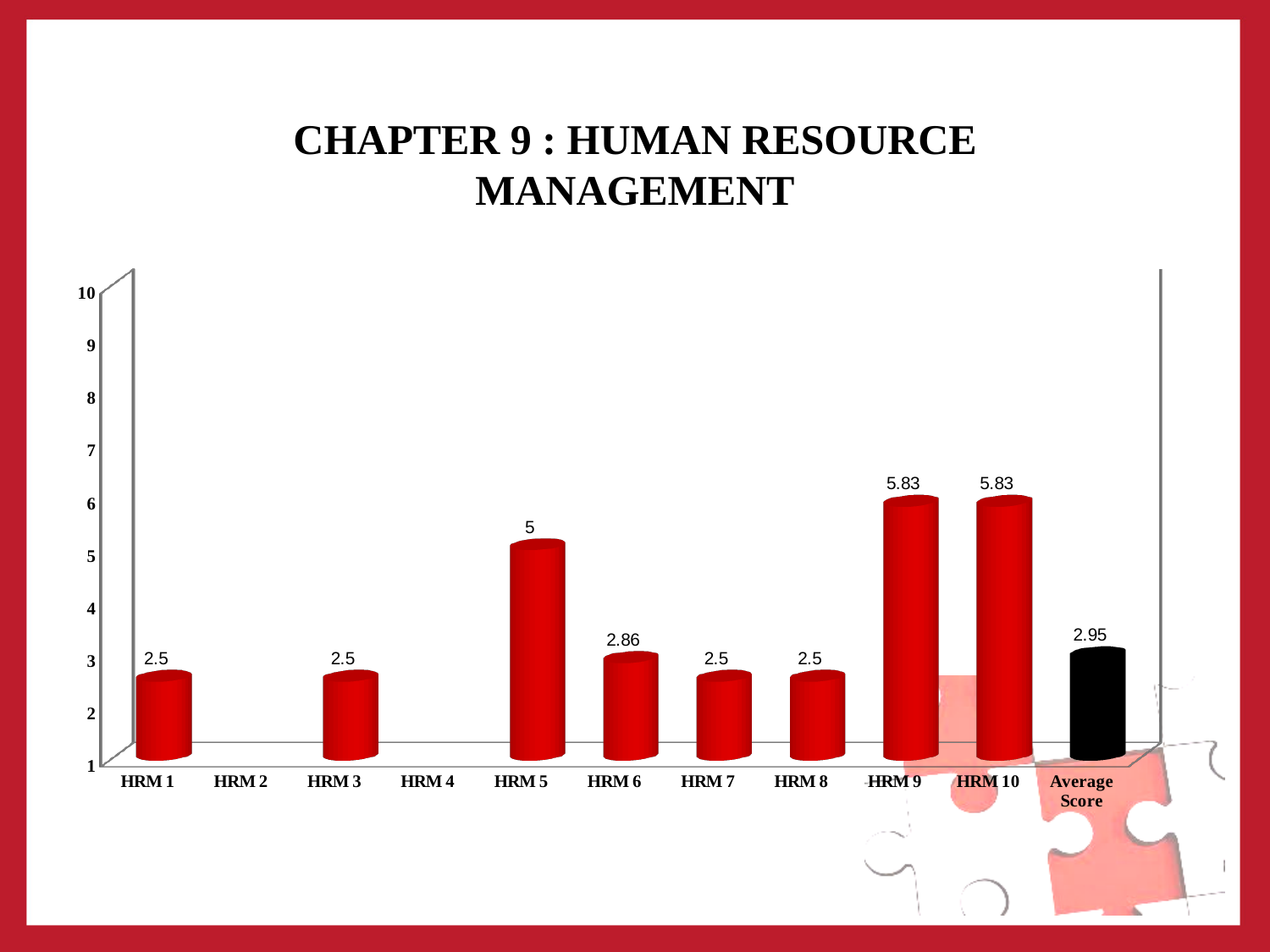
What kind of chart is shown on the slide? bar chart What is the value for HRM 1? 2.5 How many categories are shown on the x axis? 11 What is the title of the slide? CHAPTER 9 : HUMAN RESOURCE MANAGEMENT What is the value for HRM 6? 2.86 What is the Average Score shown in the chart? 2.95 What is the value for HRM 5? 5 What is the difference between the values for HRM 6 and HRM 7? 0.36 What is the value for HRM 9? 5.83 What is the difference between the values for HRM 9 and HRM 5? 0.83 Is the value for HRM 10 greater or less than 5? greater Which is larger, the value for HRM 6 or the value for HRM 8? HRM 6